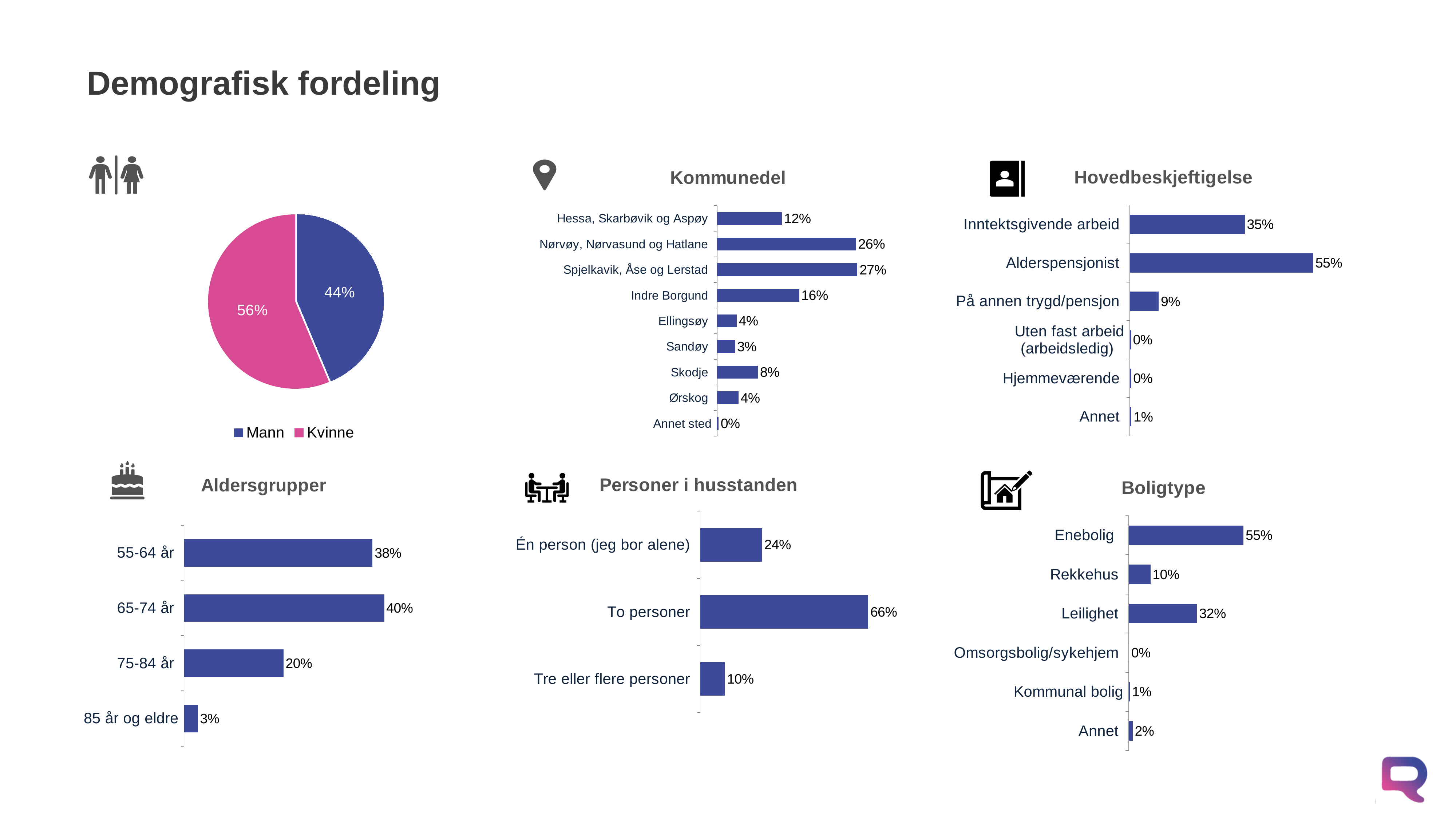
In the Kommunedel chart, which category has the highest value? Spjelkavik, Åse og Lerstad In the Kommunedel chart, what is the value for Indre Borgund? 16% In the Hovedbeskjeftigelse chart, what is the value for Alderspensjonist? 55% In the Kommunedel chart, how many categories are shown? 9 In the Aldersgrupper chart, which is larger: 55-64 år or 75-84 år? 55-64 år In the pie chart at the top left, what share is Kvinne? 56% In the Hovedbeskjeftigelse chart, what is the difference between Alderspensjonist and Inntektsgivende arbeid? 20% What kind of chart is the Boligtype chart? Bar chart In the Personer i husstanden chart, what is the value for To personer? 66% In the Personer i husstanden chart, what is the total of the three categories? 100% In the Boligtype chart, what is the value for Leilighet? 32% In the Aldersgrupper chart, which age group has the lowest value? 85 år og eldre